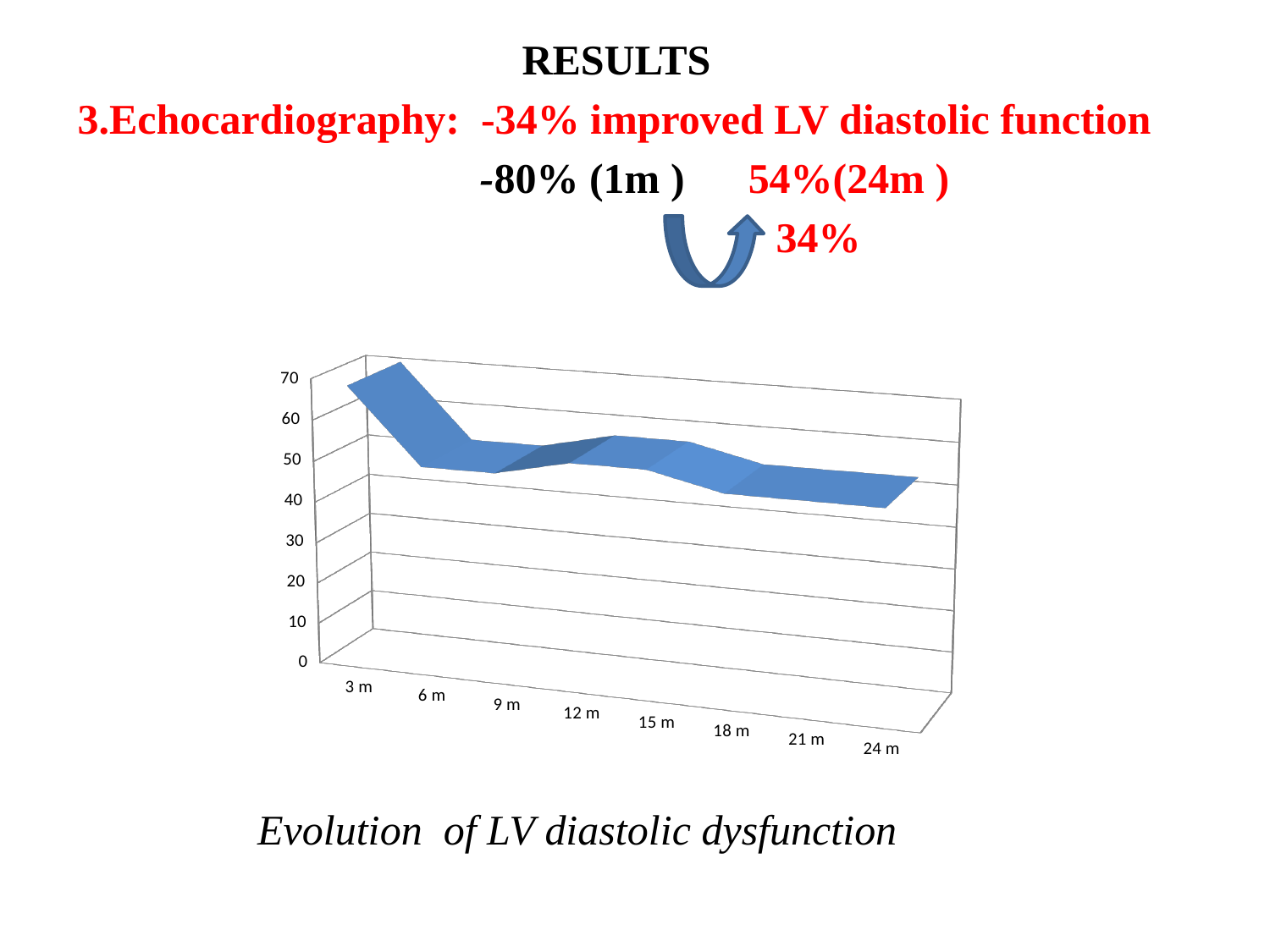
Which time point has the highest value in the chart? 3 m What is the highest tick value shown on the vertical axis of the chart? 70 Is the value at 24 m greater or less than 60? less Which is larger, the value at 3 m or the value at 24 m? 3 m Is the value at 18 m greater or less than 30? greater Is the value at 3 m greater or less than 50? greater What is the caption written below the chart? Evolution of LV diastolic dysfunction What kind of chart is shown on the slide? line chart What is the first time point label on the x axis of the chart? 3 m Do the values in the chart generally rise or fall from 3 m to 24 m? fall How many time points are plotted along the x axis of the chart? 8 Which is larger, the value at 3 m or the value at 12 m? 3 m